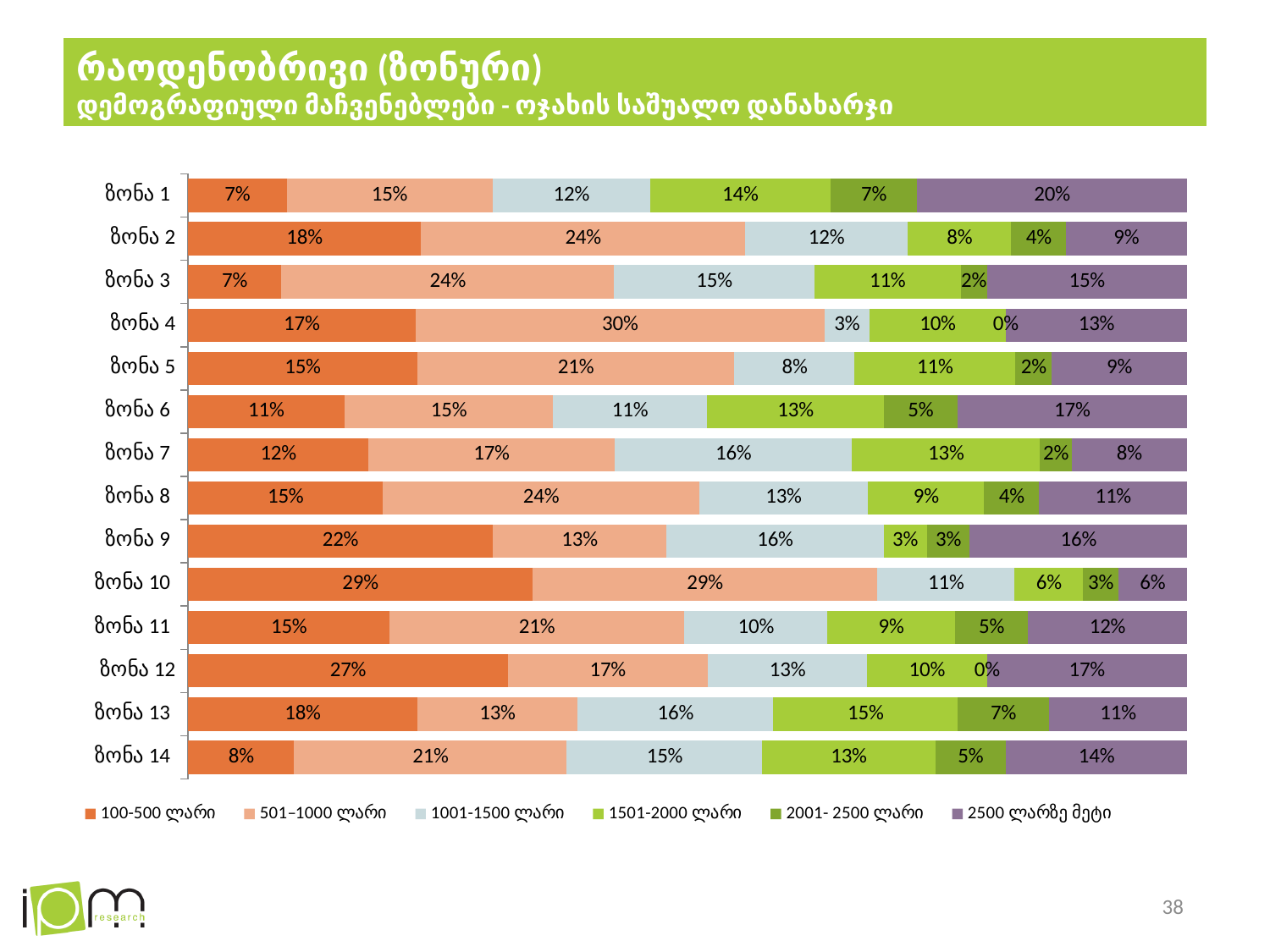
How many series does the legend list? 6 What kind of chart is shown on the slide? Stacked bar chart How many zones are shown on the chart? 14 What is the difference between the 501–1000 ლარი values for ზონა 4 and ზონა 13? 17% What is the value for 2500 ლარზე მეტი in ზონა 1? 20% What is the value for 1001-1500 ლარი in ზონა 9? 16% Which is larger: the 1501-2000 ლარი value for ზონა 13 or for ზონა 9? ზონა 13 Which zone has the lowest value for the 2500 ლარზე მეტი category? ზონა 10 Which zone has the highest value for the 100-500 ლარი category? ზონა 10 What percentage of households in ზონა 4 fall in the 501–1000 ლარი category? 30% Which legend entry is shown in purple? 2500 ლარზე მეტი Which zones show 0% for the 2001- 2500 ლარი category? ზონა 4 and ზონა 12